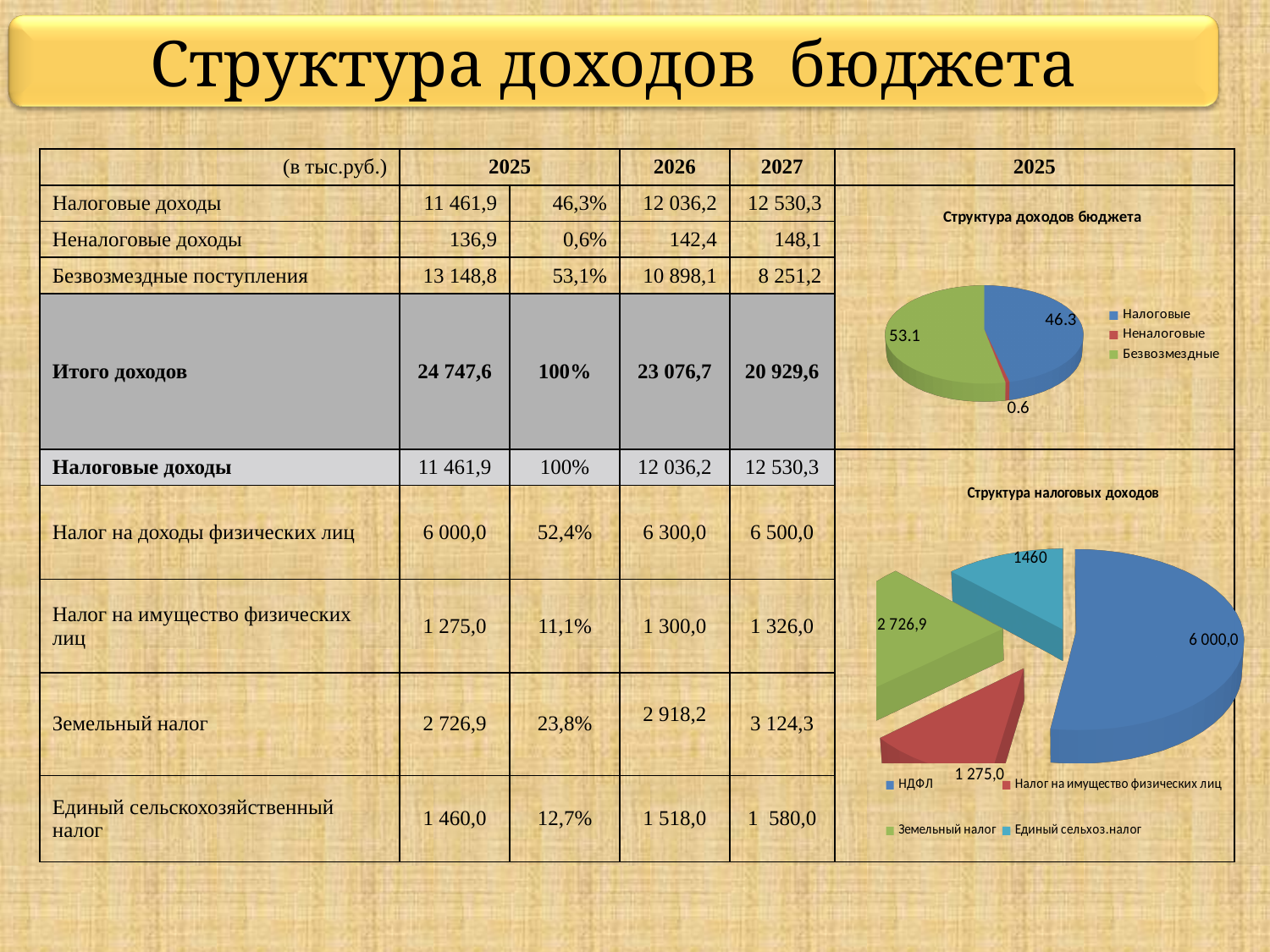
In the chart titled "Структура налоговых доходов", which is larger: Земельный налог or Единый сельхоз.налог? Земельный налог What kind of chart is the chart titled "Структура доходов бюджета"? pie chart In the chart titled "Структура налоговых доходов", which category has the smallest slice? Налог на имущество физических лиц In the chart titled "Структура налоговых доходов", how many slices does the pie have? 4 In the chart titled "Структура доходов бюджета", what value is shown for Неналоговые? 0.6 In the chart titled "Структура доходов бюджета", what value is shown for Налоговые? 46.3 How many entries does the legend of the chart titled "Структура доходов бюджета" list? 3 In the chart titled "Структура доходов бюджета", which category has the largest slice? Безвозмездные In the chart titled "Структура доходов бюджета", what value is shown for Безвозмездные? 53.1 In the chart titled "Структура доходов бюджета", which category has the smallest slice? Неналоговые In the chart titled "Структура налоговых доходов", what value is shown for Земельный налог? 2 726,9 In the chart titled "Структура налоговых доходов", what value is shown for НДФЛ? 6 000,0